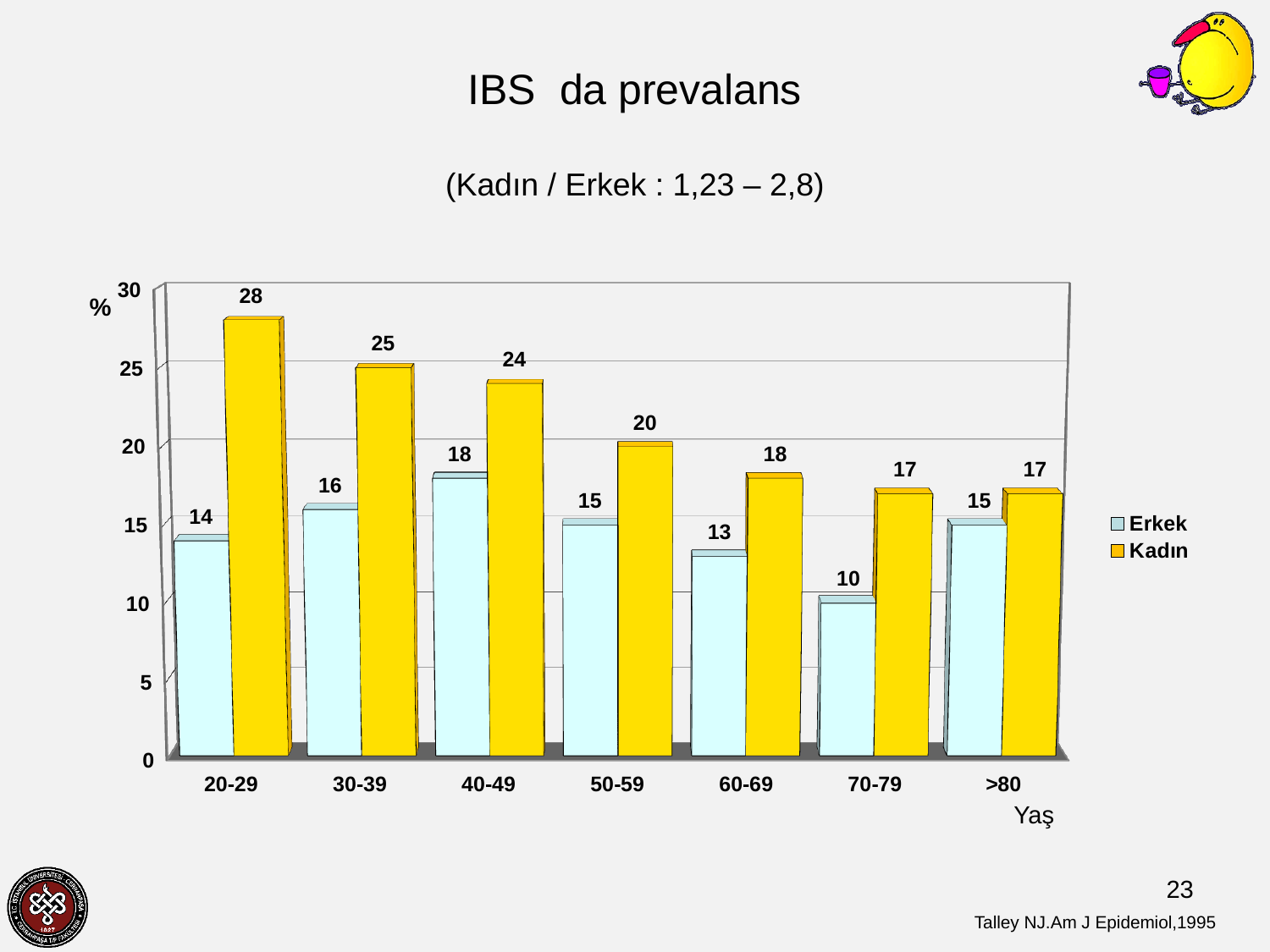
Which age group has the highest Kadın value? 20-29 What is the Erkek value for the 40-49 age group? 18 What is the difference between the Kadın and Erkek values for the 20-29 age group? 14 How many age groups are shown on the x axis? 7 What is the title of the slide containing the chart? IBS da prevalans How many series does the legend list? 2 What is the Kadın value for the 20-29 age group? 28 What kind of chart is shown on the slide? bar chart Do the Kadın values generally rise or fall from the 20-29 group to the 70-79 group? fall Which is larger for the 60-69 age group, the Erkek value or the Kadın value? Kadın Which age group has the lowest Erkek value? 70-79 What is the Erkek value for the 70-79 age group? 10